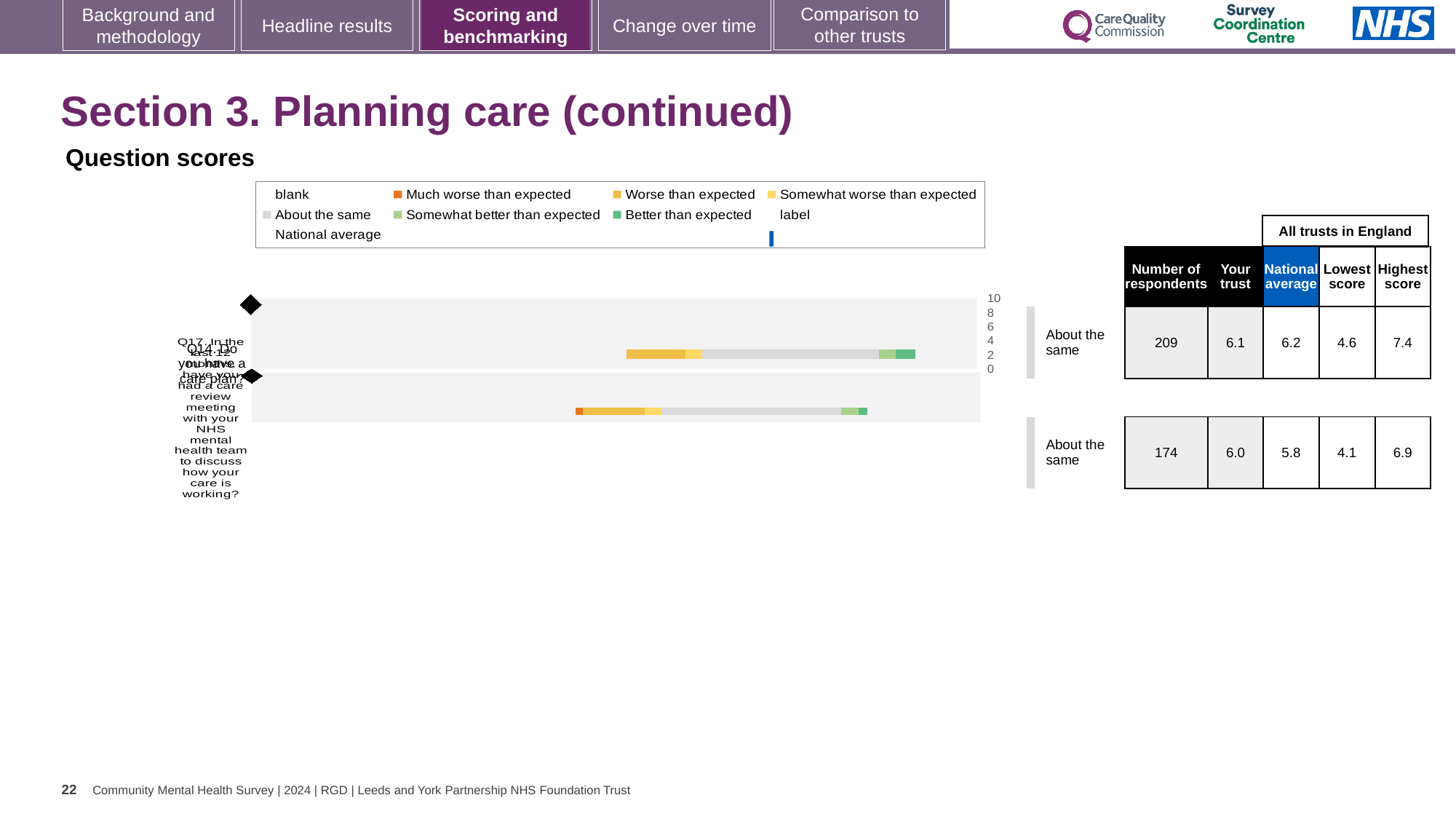
For the top row (Q14), which is larger: the 'Your trust' score or the national average? National average In the table, what is the number of respondents for the top row (Q14)? 209 Which row has more respondents, the top row (Q14) or the bottom row (Q17)? Q14 (top row) What colour does the legend use for 'Much worse than expected'? Orange In the table, what is the national average for the top row (Q14)? 6.2 In the table, what is the 'Your trust' score for the bottom row (Q17)? 6.0 What kind of chart is shown under 'Question scores'? bar chart How many question bars are plotted in the chart? 2 In the table, what is the highest score among all trusts in England for the bottom row (Q17)? 6.9 For the bottom row (Q17), what is the difference between the highest score (6.9) and the lowest score (4.1)? 2.8 What colour does the legend use for 'National average'? Blue What benchmark label is shown next to each bar in the chart? About the same